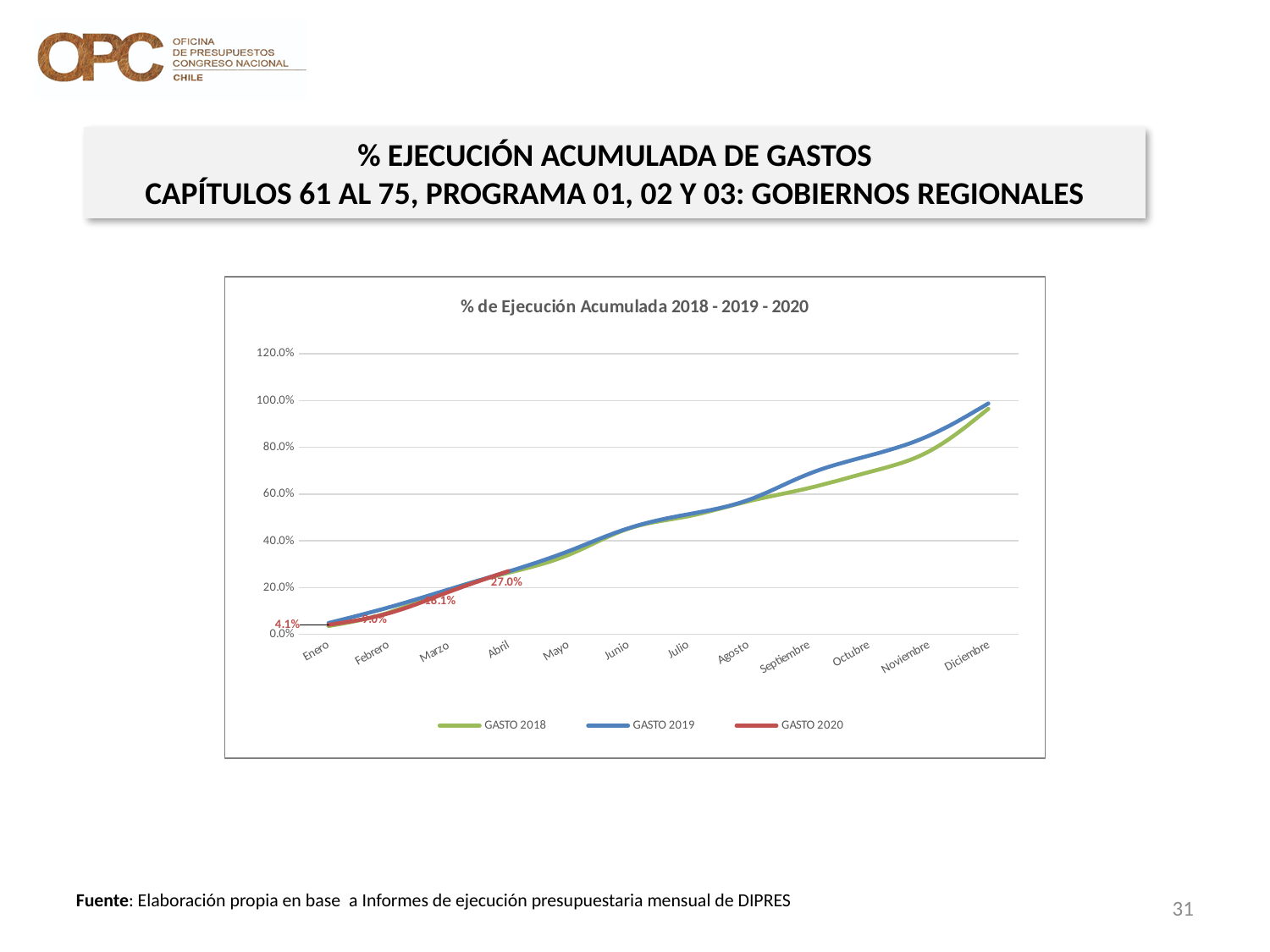
What kind of chart is shown on the slide? line chart Is the value for GASTO 2019 in Junio greater or less than 60.0%? less How many months are shown along the x axis? 12 Do the values for GASTO 2019 rise or fall from Enero to Diciembre? rise Is the value for GASTO 2018 in Septiembre greater or less than 80.0%? less What is the title of the chart? % de Ejecución Acumulada 2018 - 2019 - 2020 What is the value for GASTO 2020 in Abril? 27.0% Is the value for GASTO 2019 in Diciembre greater or less than 80.0%? greater What is the difference between the GASTO 2020 values for Abril and Enero? 22.9% What is the value for GASTO 2020 in Enero? 4.1% How many series does the legend list? 3 In Octubre, which series has the higher value, GASTO 2018 or GASTO 2019? GASTO 2019